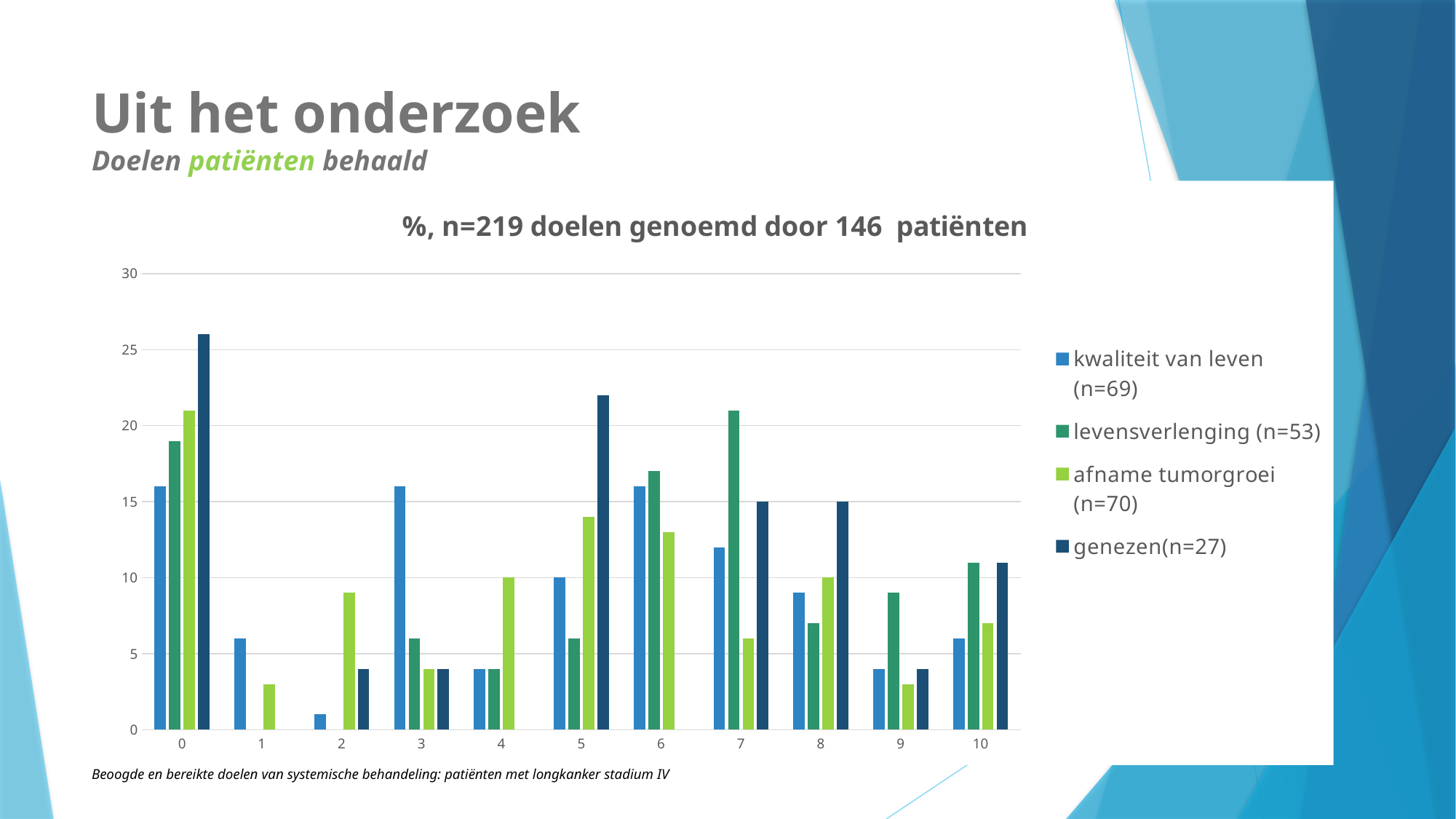
In category 3, which is larger: kwaliteit van leven (n=69) or levensverlenging (n=53)? kwaliteit van leven (n=69) What kind of chart is shown on the slide? bar chart What is the title of the chart? %, n=219 doelen genoemd door 146 patiënten What is the value for kwaliteit van leven (n=69) in category 5? 10 Which series has the highest bar in category 0? genezen(n=27) How many categories are shown along the x axis? 11 What is the value for genezen(n=27) in category 7? 15 What is the value for afname tumorgroei (n=70) in category 4? 10 Is the value for levensverlenging (n=53) in category 7 greater or less than 20? greater Is the value for kwaliteit van leven (n=69) in category 2 greater or less than 5? less How many series does the legend list? 4 Is the value for genezen(n=27) in category 0 greater or less than 25? greater